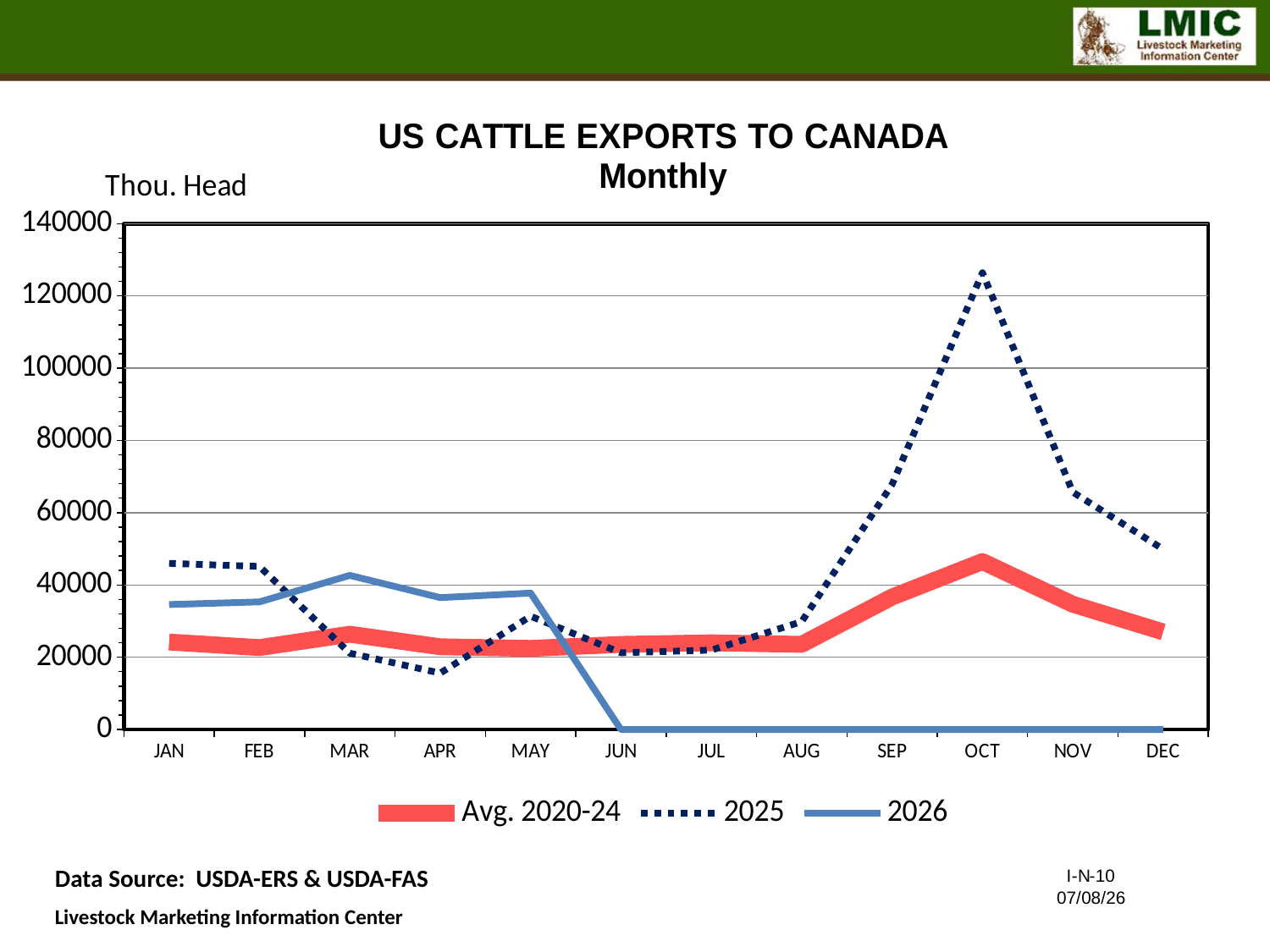
Does the 2025 series rise or fall from AUG to OCT? rise Is the 2025 value for APR greater or less than 20000? less Is the 2025 value for OCT greater or less than 100000? greater How many series does the legend list? 3 In which month does the 2025 series reach its lowest value? APR How many months are shown along the x axis? 12 What kind of chart is shown on the slide? line chart Which is larger in JAN, the 2025 value or the 2026 value? 2025 In which month does the 2025 series reach its highest value? OCT What unit label is shown above the y axis? Thou. Head Is the Avg. 2020-24 value for OCT greater or less than 40000? greater In which month does the Avg. 2020-24 series reach its highest value? OCT